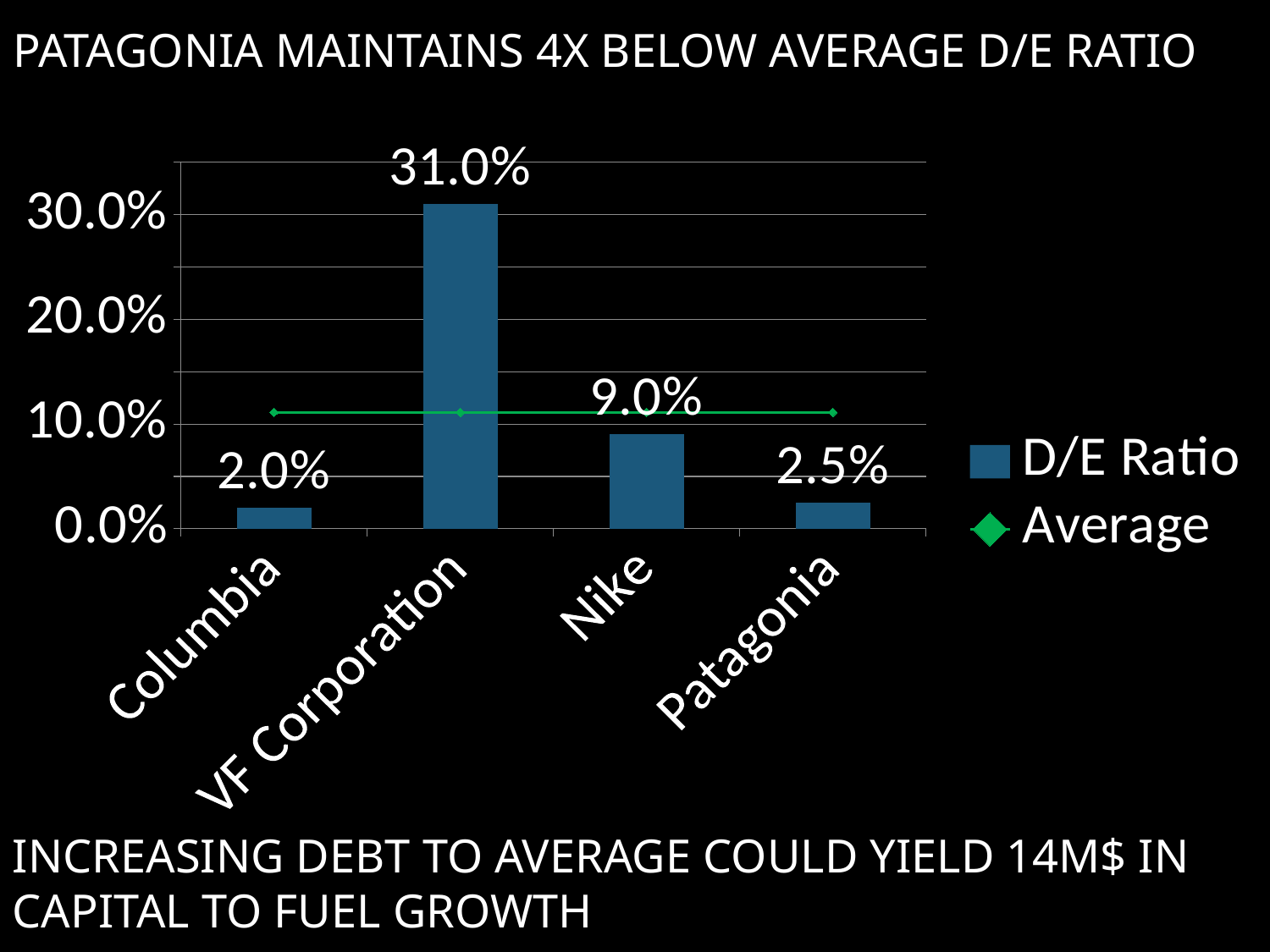
What is the D/E Ratio for Nike? 9.0% How many companies are shown on the x axis? 4 What is the D/E Ratio for Columbia? 2.0% What kind of chart is used to show the D/E Ratio values? bar chart Which company has the lowest D/E Ratio? Columbia What is the difference between the D/E Ratio of VF Corporation and Nike? 22.0% Which company has the highest D/E Ratio? VF Corporation How many series does the legend list? 2 What is the D/E Ratio for Patagonia? 2.5% Is the Average line greater or less than 10.0%? greater What is the D/E Ratio for VF Corporation? 31.0% Which has a larger D/E Ratio, Nike or Patagonia? Nike